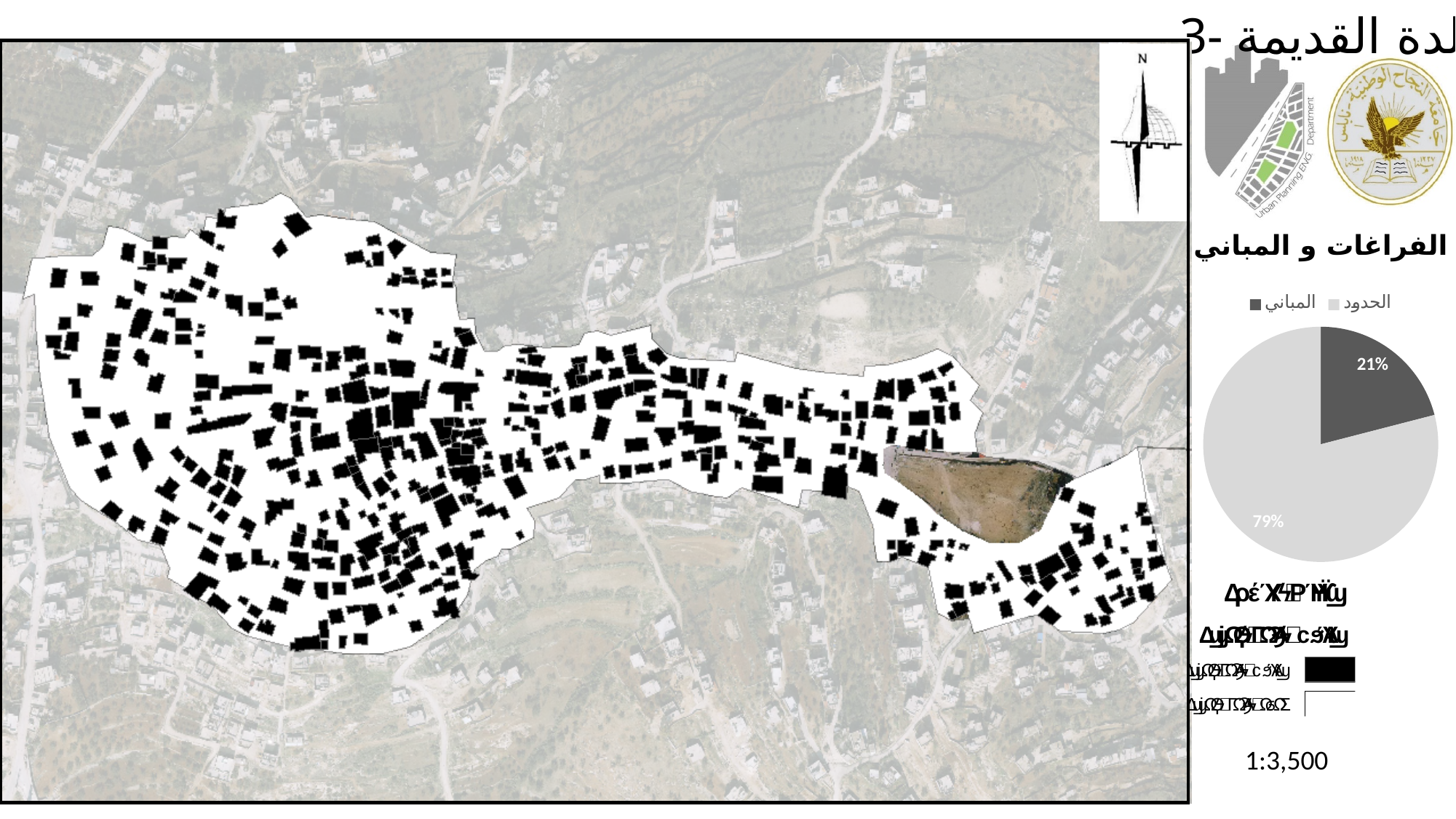
What is the difference in percentage points between the الحدود slice and the المباني slice in the pie chart? 58 In the pie chart, what share is labelled for المباني? 21% Which slice of the pie chart is the smallest? المباني What colour is the المباني slice in the pie chart? dark grey How many entries does the pie chart's legend list? 2 What kind of chart is shown on the right side of the slide? pie chart Which slice of the pie chart is the largest? الحدود In the pie chart, what share is labelled for الحدود? 79% In the pie chart, which is larger: المباني or الحدود? الحدود How many slices does the pie chart have? 2 What is the heading written above the pie chart? الفراغات و المباني